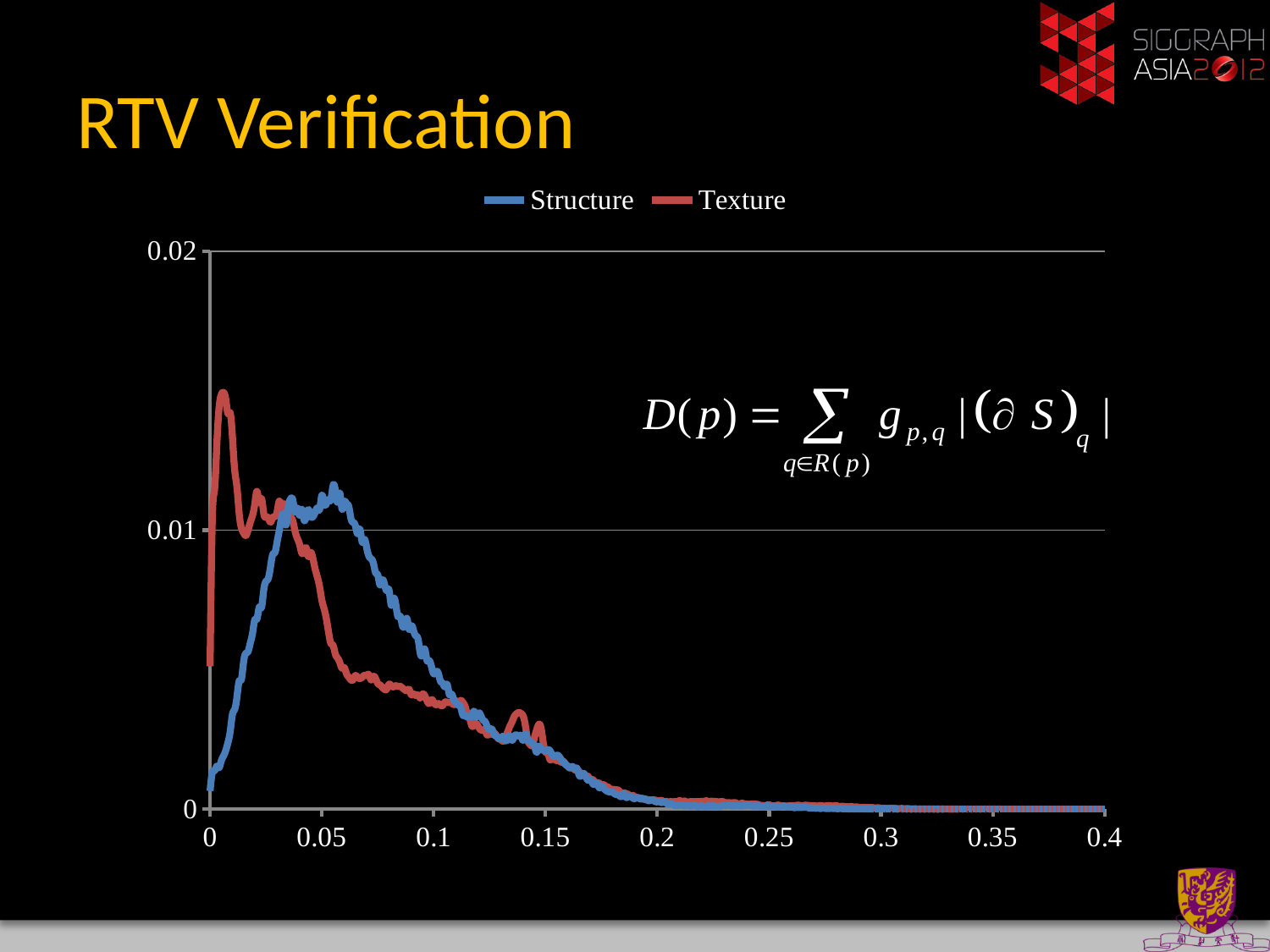
Is the value of the Structure series at x = 0.1 greater or less than 0.01? less Do the values of both series rise or fall along the x axis from 0.1 to 0.4? fall What kind of chart is shown on the slide? line chart At x = 0.01, which series has the larger value, Structure or Texture? Texture Is the peak value of the Texture series greater or less than 0.01? greater What are the two series named in the legend? Structure and Texture Which series reaches the highest peak value on the chart? Texture How many series does the legend list? 2 Is the value of the Texture series at x = 0.3 greater or less than 0.01? less Which colour is used for the Texture series? red At x = 0.1, which series has the larger value, Structure or Texture? Structure